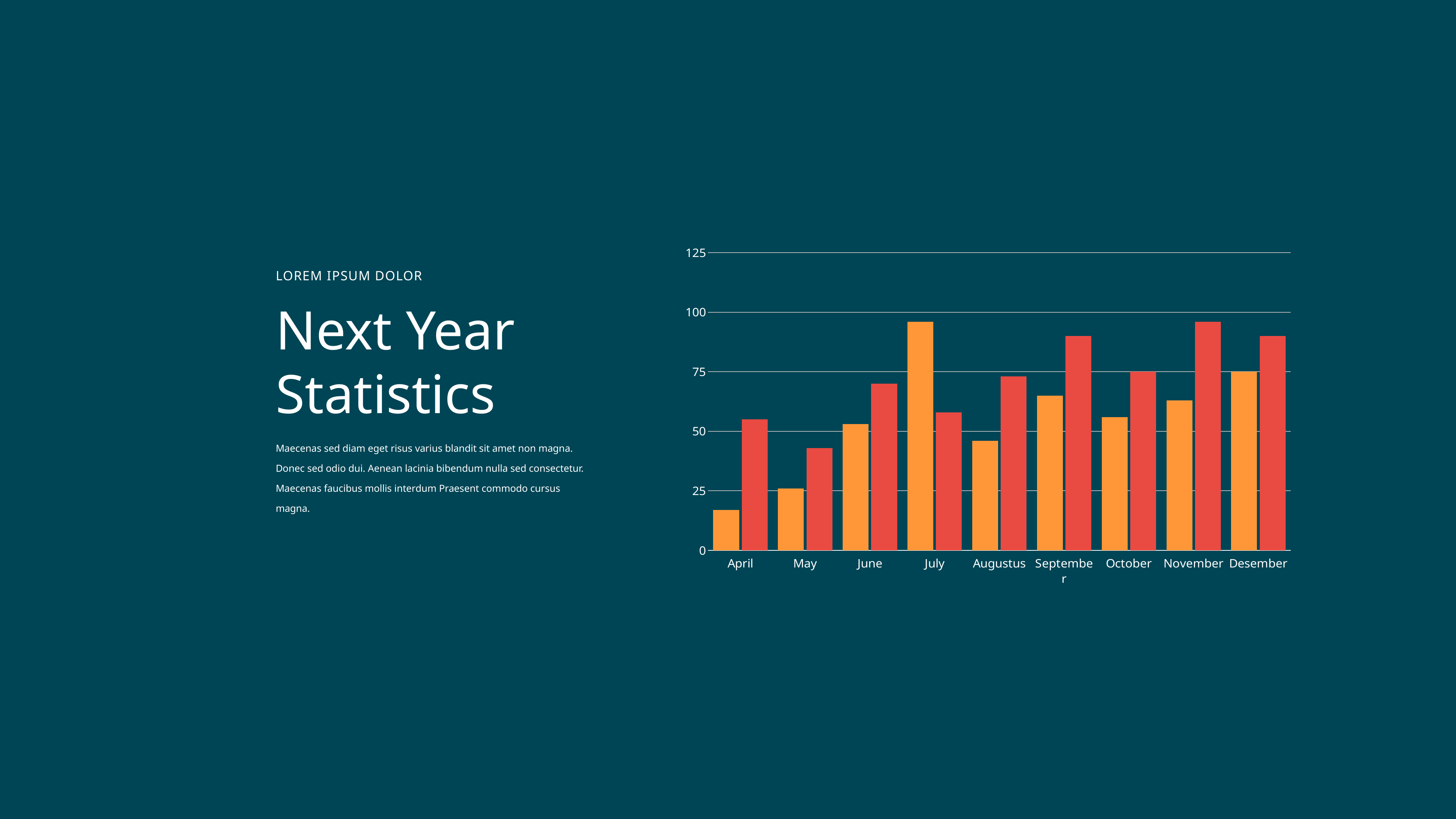
Is the value of the red bar for September greater or less than 75? greater How many data series are plotted in the chart? 2 For July, which bar is taller, the orange one or the red one? orange For April, which bar is taller, the orange one or the red one? red Is the value of the orange bar for July greater or less than 75? greater Is the value of the red bar for May greater or less than 50? less Which month has the shortest red bar? May What kind of chart is shown on the slide? bar chart Which month has the shortest orange bar? April How many months are shown on the x axis of the chart? 9 Which month has the tallest orange bar? July